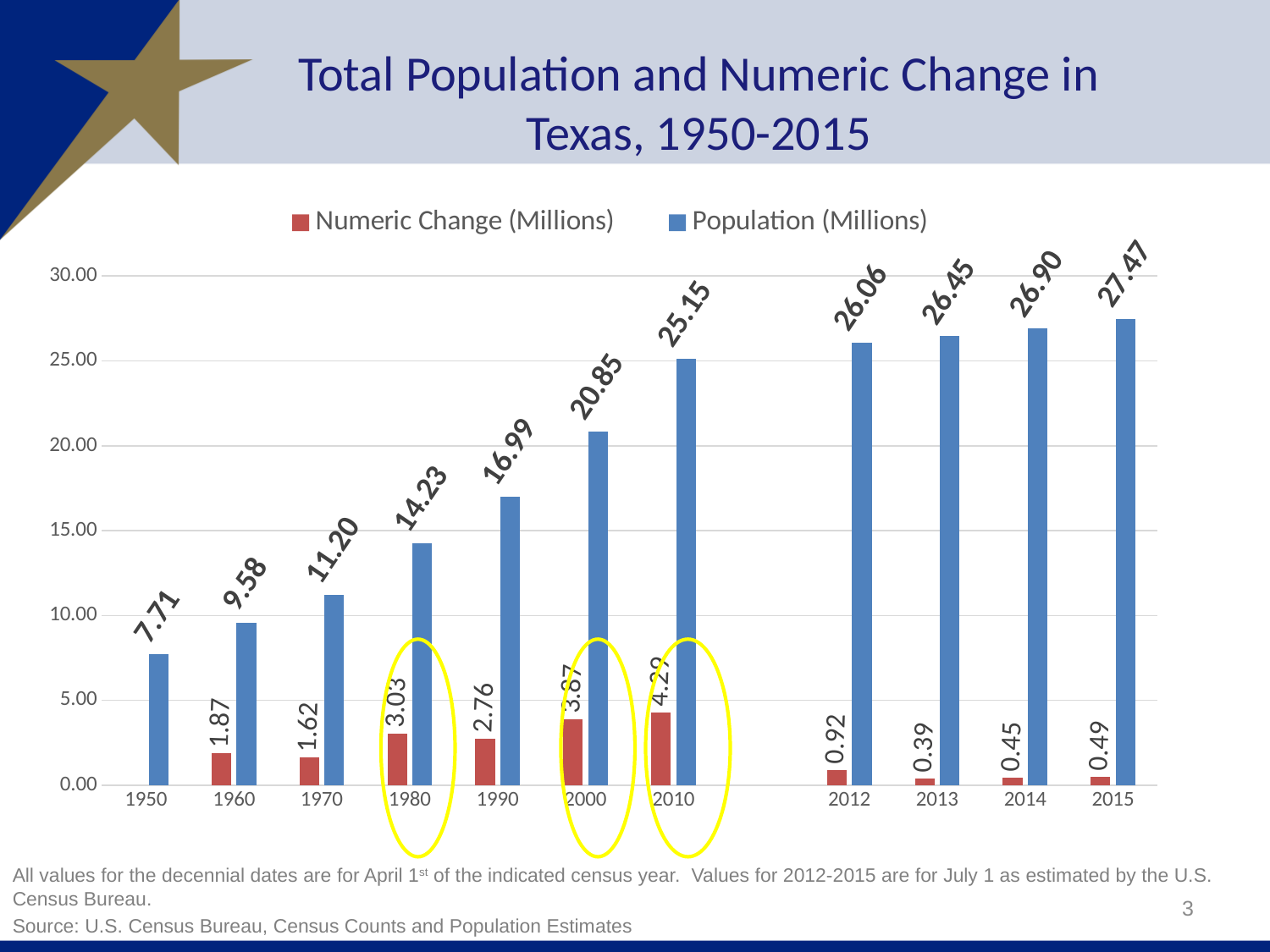
Does the Population (Millions) series rise or fall from 1950 to 2015? rise What is the Numeric Change (Millions) value for 2013? 0.39 How many years are shown on the x axis? 11 Is the Population (Millions) value for 1990 greater or less than 15.00? greater What is the difference between the Population (Millions) values for 2015 and 2010? 2.32 What is the Population (Millions) value for 2015? 27.47 Which year has the highest Population (Millions) value? 2015 What is the Population (Millions) value for 1950? 7.71 Which year has the lowest Numeric Change (Millions) value? 2013 What is the Numeric Change (Millions) value for 1980? 3.03 Which year has the larger Numeric Change (Millions) value, 1960 or 1970? 1960 How many series does the legend list? 2